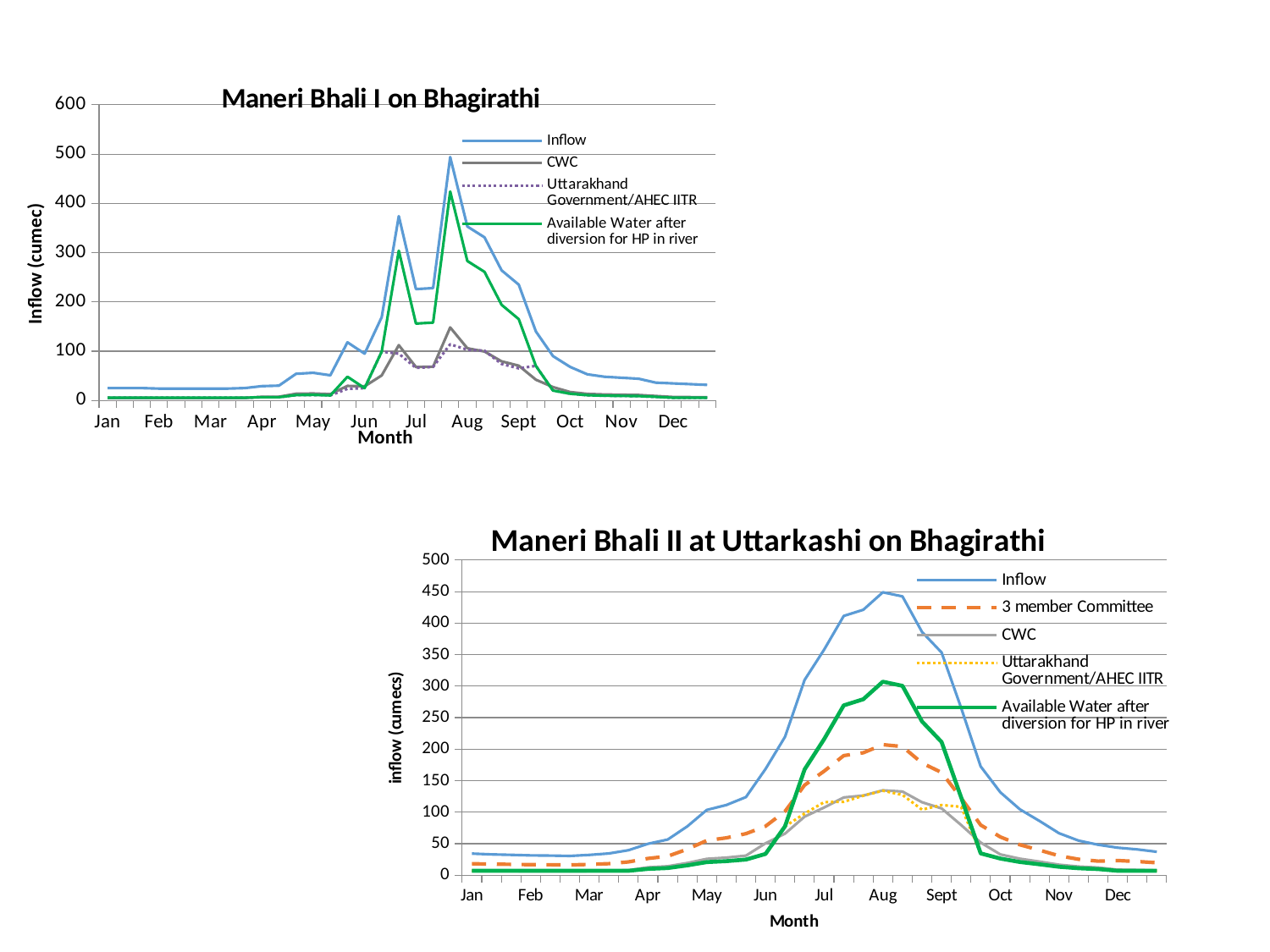
In "Maneri Bhali II at Uttarkashi on Bhagirathi", does the Inflow series rise or fall from Aug to Dec? Fall In "Maneri Bhali I on Bhagirathi", is the peak value of Inflow greater or less than 400? greater What kind of chart is "Maneri Bhali I on Bhagirathi"? Line chart In "Maneri Bhali II at Uttarkashi on Bhagirathi", is the peak value of "Available Water after diversion for HP in river" greater or less than 250? greater In "Maneri Bhali II at Uttarkashi on Bhagirathi", is the peak value of Inflow greater or less than 400? greater How many series does the legend of "Maneri Bhali II at Uttarkashi on Bhagirathi" list? 5 In "Maneri Bhali I on Bhagirathi", which series reaches the highest value? Inflow In "Maneri Bhali II at Uttarkashi on Bhagirathi", which series has the highest value in Aug? Inflow What is the y-axis label of "Maneri Bhali I on Bhagirathi"? Inflow (cumec) In "Maneri Bhali II at Uttarkashi on Bhagirathi", which is larger in Jul, Inflow or CWC? Inflow How many series does the legend of "Maneri Bhali I on Bhagirathi" list? 4